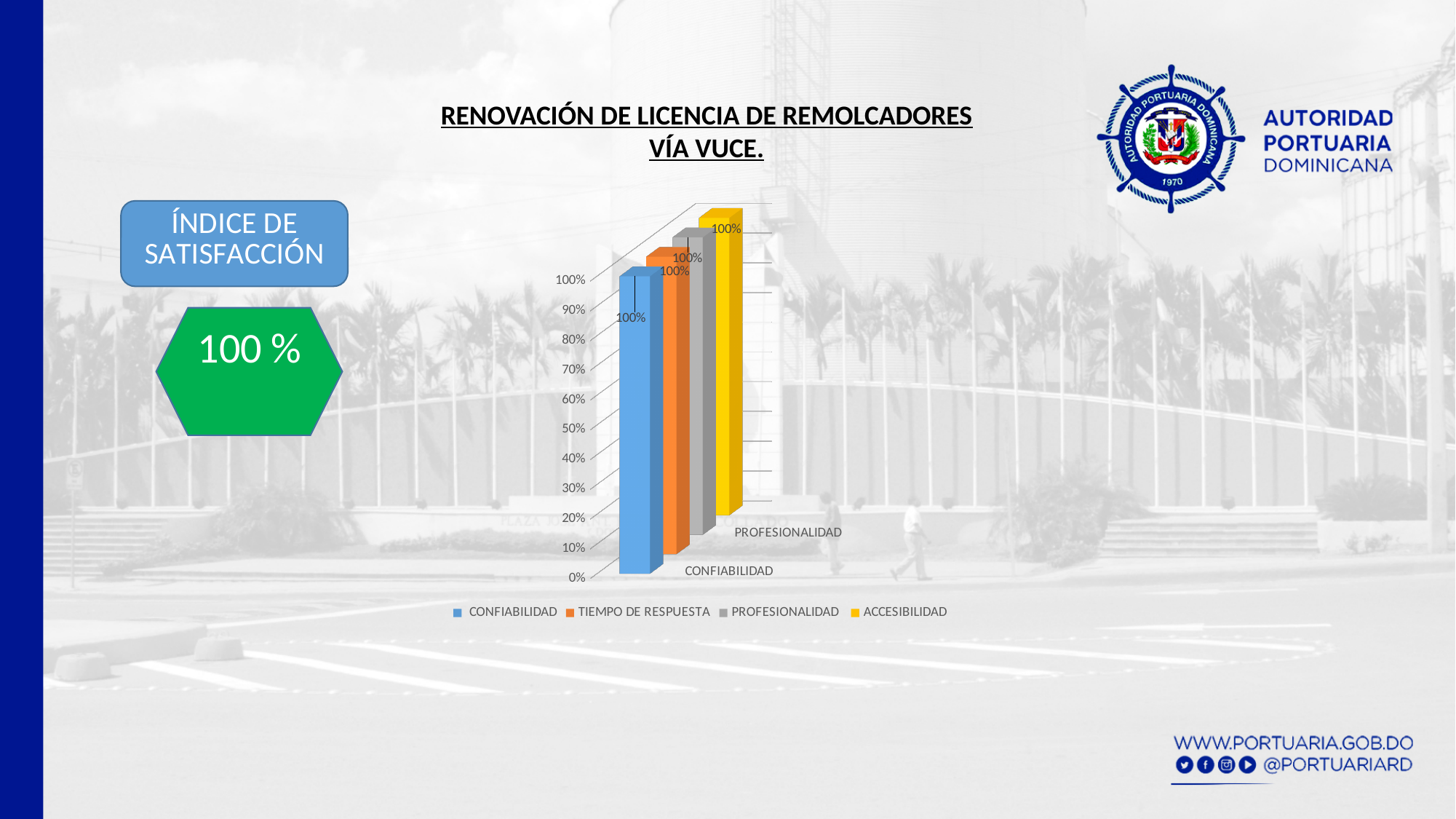
How many bars are plotted in the chart? 4 Is the value for PROFESIONALIDAD greater or less than 50%? greater How many entries does the legend list? 4 What is the difference between the values for CONFIABILIDAD and ACCESIBILIDAD? 0% What kind of chart is shown on the slide? bar chart What is the title of the chart? RENOVACIÓN DE LICENCIA DE REMOLCADORES VÍA VUCE. What is the value for CONFIABILIDAD? 100% Which legend entry is shown in yellow? ACCESIBILIDAD What is the value for TIEMPO DE RESPUESTA? 100% What is the value for ACCESIBILIDAD? 100% What is the value for PROFESIONALIDAD? 100%